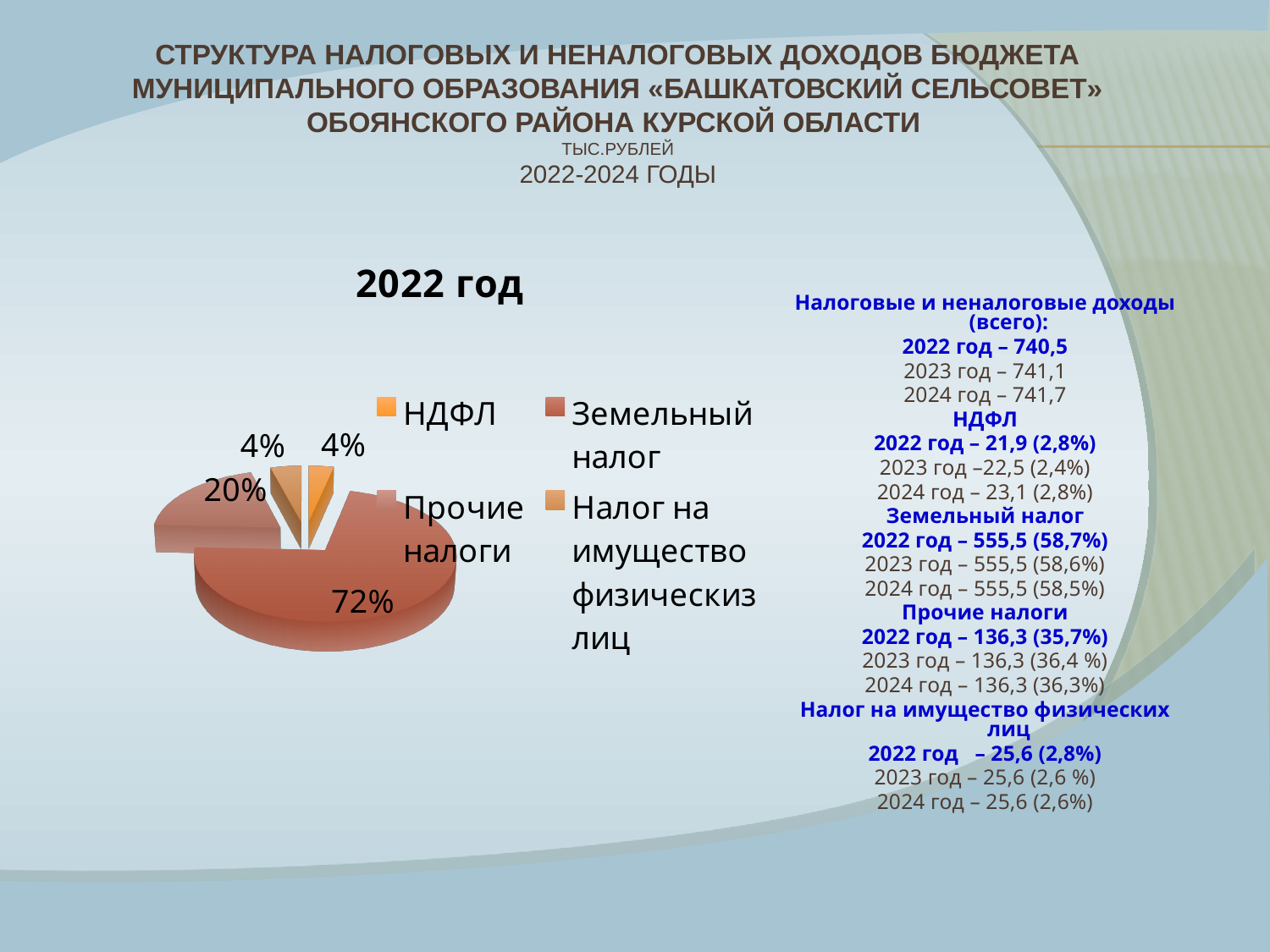
What kind of chart is shown on the slide? pie chart What share of the pie does Налог на имущество физических лиц have? 4% What is the difference in percentage points between the Земельный налог slice and the Прочие налоги slice? 52 How many entries does the legend of the pie chart list? 4 What is the title of the pie chart? 2022 год Which slice is larger, Прочие налоги or НДФЛ? Прочие налоги Which category has the largest slice of the pie? Земельный налог How many slices does the pie chart have? 4 What share of the pie does Земельный налог have? 72% What share of the pie does Прочие налоги have? 20% What is the combined share of the НДФЛ and Налог на имущество физических лиц slices? 8%